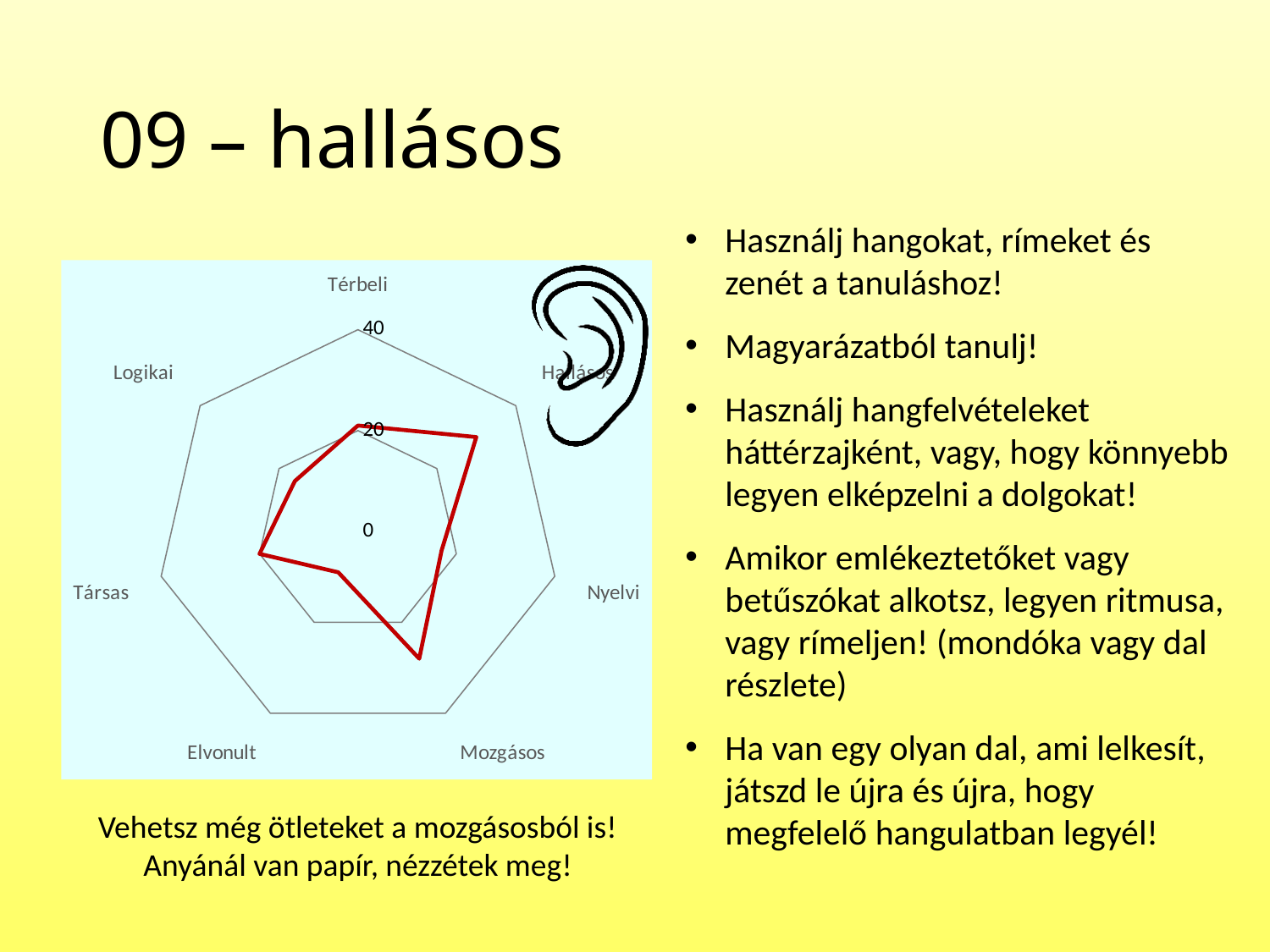
Which has the larger value, Hallásos or Elvonult? Hallásos What kind of chart is shown on the slide? radar chart Which has the larger value, Mozgásos or Logikai? Mozgásos What colour is the data line on the radar chart? red What is the highest value shown on the radar chart's axis? 40 Is the value for Mozgásos greater or less than 20? greater How many categories does the radar chart have? 7 Which category has the lowest value on the radar chart? Elvonult Is the value for Elvonult greater or less than 20? less Is the value for Logikai greater or less than 20? less